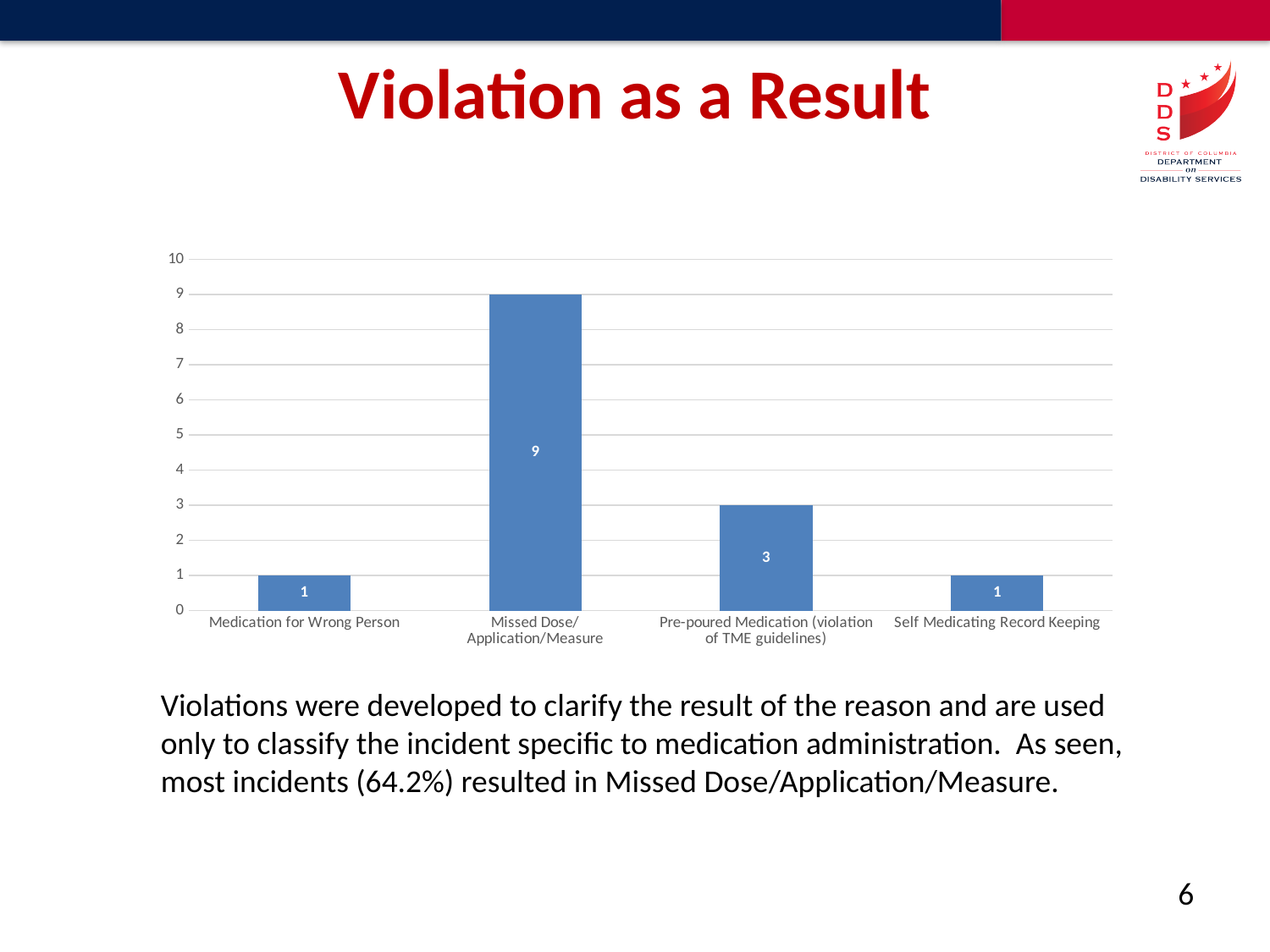
What is the value for Medication for Wrong Person? 1 What is the value for Missed Dose/Application/Measure? 9 Is the value for Missed Dose/Application/Measure greater or less than 5? greater What is the value for Self Medicating Record Keeping? 1 What is the title of the slide containing the chart? Violation as a Result Which is larger, the value for Pre-poured Medication (violation of TME guidelines) or the value for Self Medicating Record Keeping? Pre-poured Medication (violation of TME guidelines) Which category has the highest value? Missed Dose/Application/Measure How many categories are shown on the x axis? 4 What is the value for Pre-poured Medication (violation of TME guidelines)? 3 What is the total of all four bar values? 14 What is the difference between the values for Missed Dose/Application/Measure and Pre-poured Medication (violation of TME guidelines)? 6 What kind of chart is shown on the slide? Bar chart